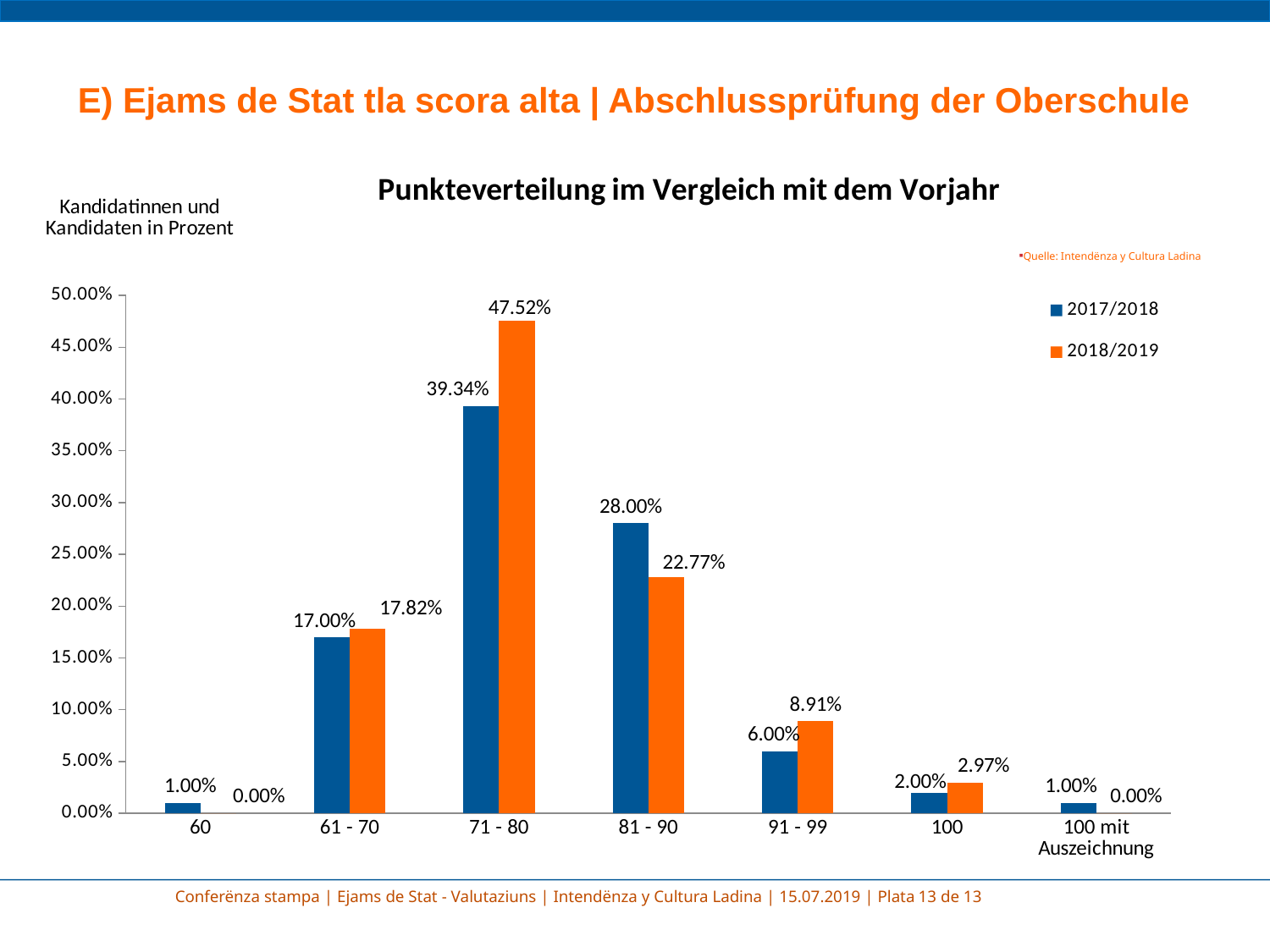
What is the value for 2017/2018 in the 81 - 90 category? 28.00% Which category has the highest value for 2017/2018? 71 - 80 What is the title of the chart? Punkteverteilung im Vergleich mit dem Vorjahr In the 61 - 70 category, which series has the larger value, 2017/2018 or 2018/2019? 2018/2019 How many categories are shown on the x axis? 7 Is the 2017/2018 value for 71 - 80 greater or less than 35.00%? greater What is the difference between the 2017/2018 and 2018/2019 values in the 81 - 90 category? 5.23% What kind of chart is shown on the slide? bar chart What is the value for 2018/2019 in the 71 - 80 category? 47.52% What is the difference between the 2018/2019 and 2017/2018 values in the 71 - 80 category? 8.18% How many series does the legend list? 2 What is the value for 2018/2019 in the 91 - 99 category? 8.91%